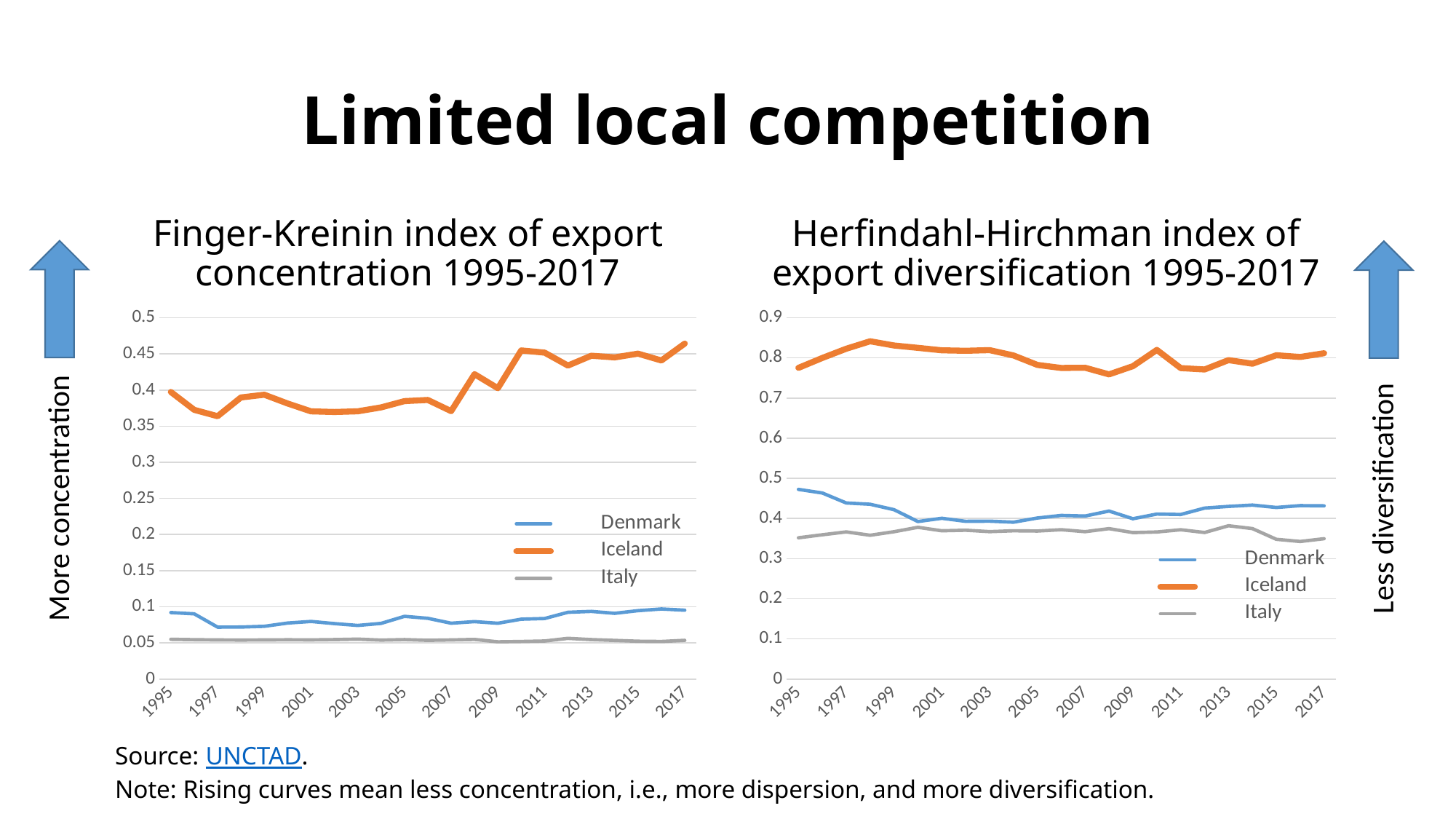
In the Herfindahl-Hirchman index of export diversification 1995-2017 chart, is the value for Denmark in 1995 greater or less than 0.5? less In the Finger-Kreinin index of export concentration 1995-2017 chart, which country has the highest values throughout the period? Iceland In the Herfindahl-Hirchman index of export diversification 1995-2017 chart, is the value for Denmark in 1995 larger or smaller than the value for Italy in 1995? larger In the Finger-Kreinin index of export concentration 1995-2017 chart, does the Iceland line overall rise or fall from 1995 to 2017? rise What kind of chart is the Finger-Kreinin index of export concentration 1995-2017 chart? line chart What is the source cited for the charts on the slide? UNCTAD How many series does the legend of the Herfindahl-Hirchman index of export diversification 1995-2017 chart list? 3 In the Herfindahl-Hirchman index of export diversification 1995-2017 chart, which country has the highest values throughout the period? Iceland In the Finger-Kreinin index of export concentration 1995-2017 chart, is the value for Iceland in 2017 greater or less than 0.45? greater In the Finger-Kreinin index of export concentration 1995-2017 chart, which country has the lowest values throughout the period? Italy In the Herfindahl-Hirchman index of export diversification 1995-2017 chart, is the value for Iceland in 1998 greater or less than 0.8? greater